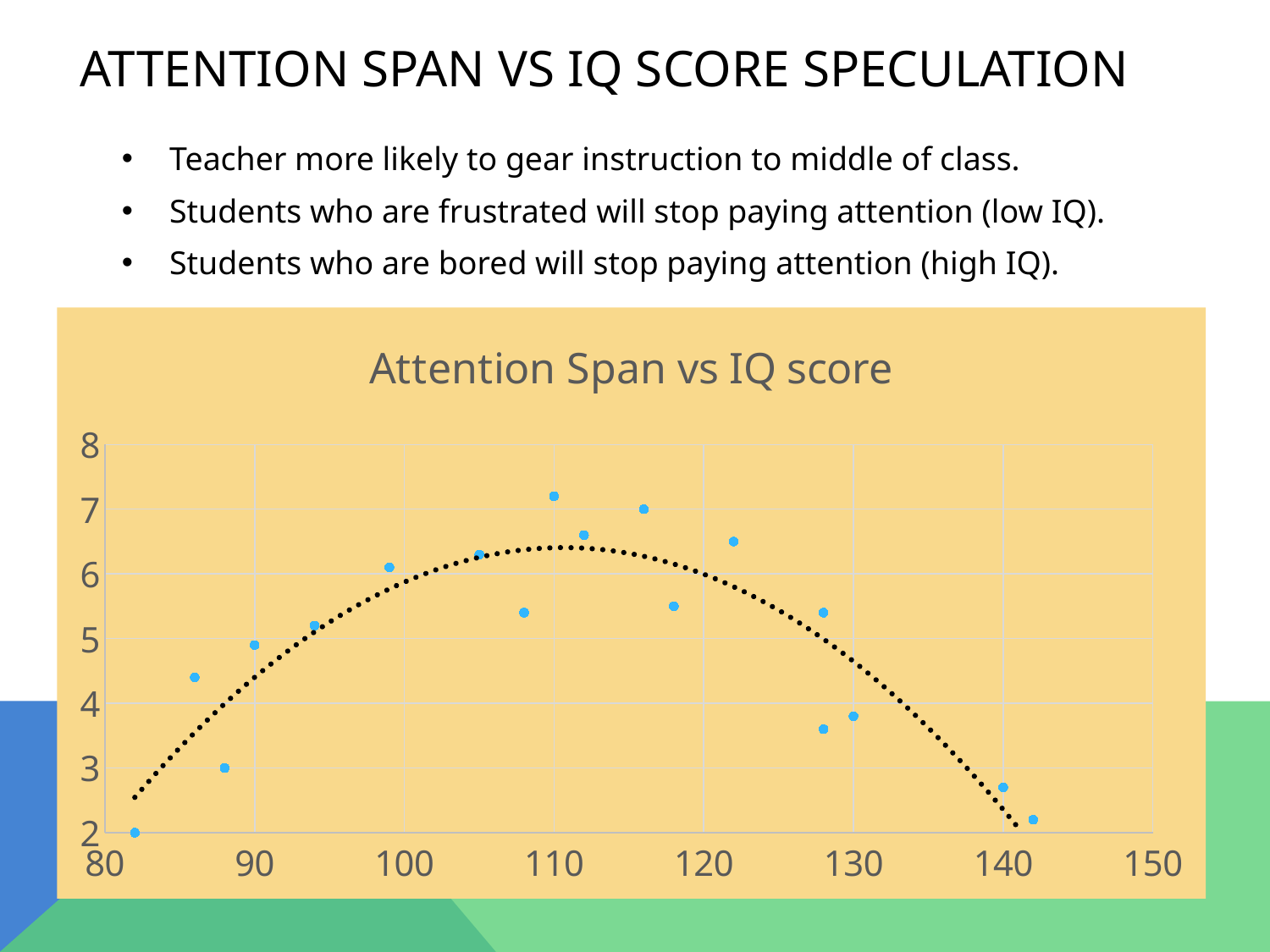
What is the highest value shown on the vertical axis of the chart? 8 Which is larger: the plotted value at an IQ score of about 110 or the plotted value at an IQ score of about 140? the value at about 110 Is the highest plotted point on the chart greater or less than 7? greater Is the plotted point at an IQ score of about 142 greater or less than 3? less What kind of chart is shown on the slide? scatter chart Does the dotted trendline rise or fall as the IQ score increases from 120 to 140? fall Does the dotted trendline rise or fall as the IQ score increases from 80 to 110? rise Is the plotted point at an IQ score of about 116 greater or less than 6? greater What is the title of the chart? Attention Span vs IQ score